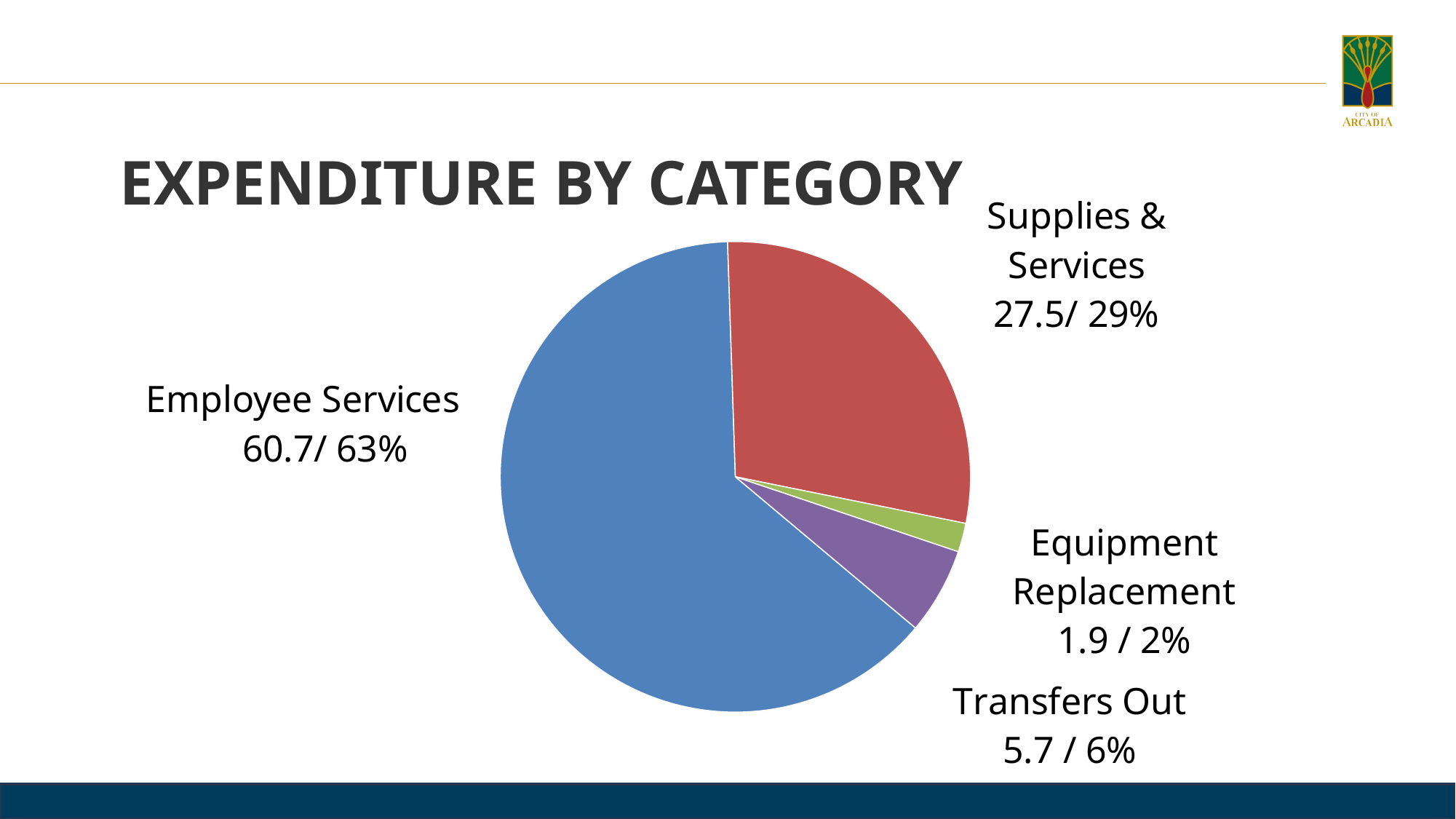
What share of expenditure is Equipment Replacement? 2% What is the title of the chart? EXPENDITURE BY CATEGORY What share of expenditure is Supplies & Services? 29% Which category has the smallest share of expenditure? Equipment Replacement Which category has the largest share of expenditure? Employee Services What is the amount shown for Employee Services? 60.7 What is the amount shown for Supplies & Services? 27.5 What kind of chart is shown on the slide? Pie chart What share of expenditure is Employee Services? 63% How many categories does the pie chart show? 4 What is the difference in amount between Employee Services and Supplies & Services? 33.2